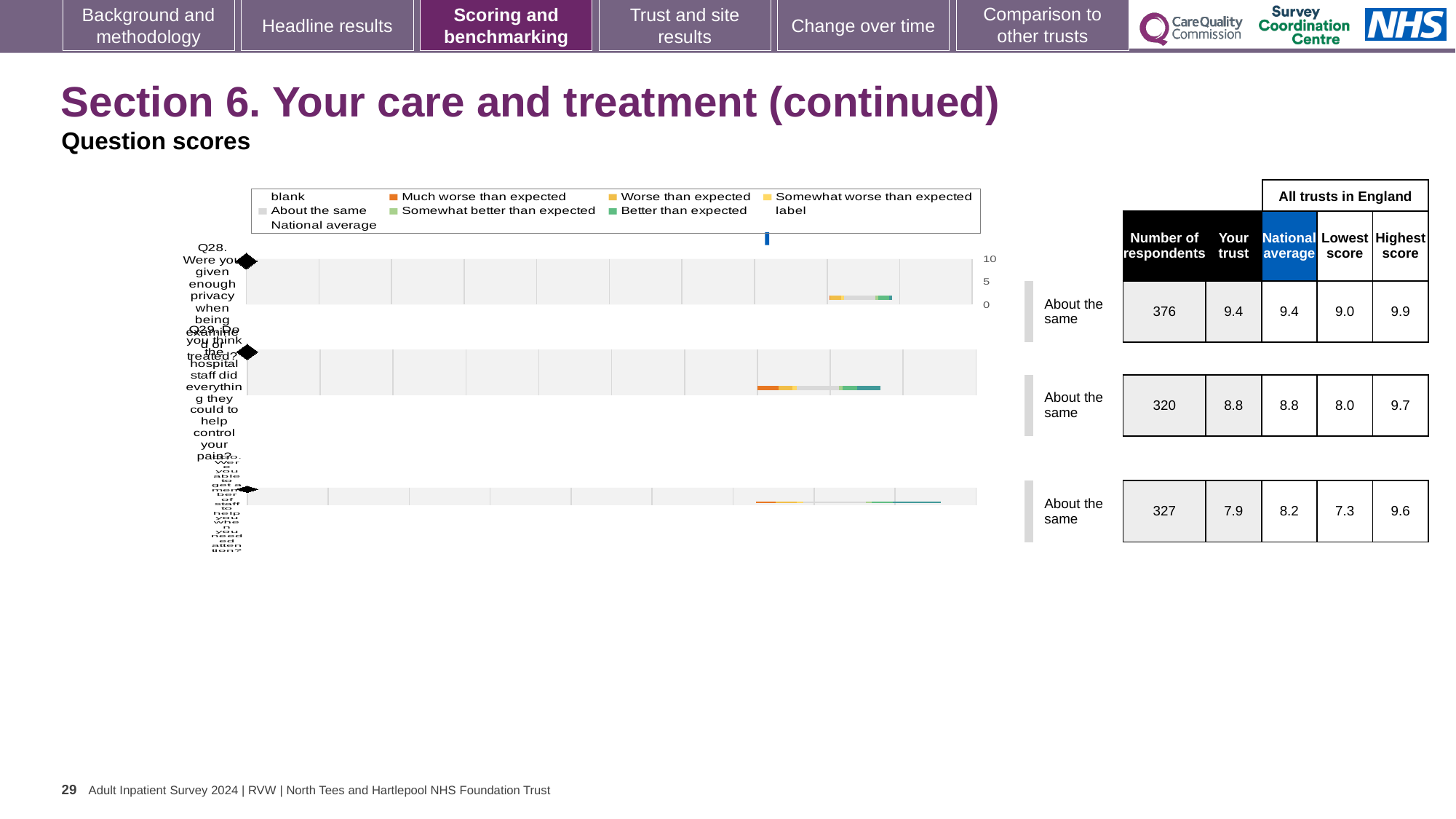
What kind of chart is used to show the question scores on this slide? bar chart Is the 'Your trust' score for Q30 greater or less than 5 on the chart axis? greater What is the difference between the highest score and the lowest score for Q29? 1.7 What benchmark category is shown for Q28? About the same What is the difference between the 'Your trust' scores for Q28 and Q30? 1.5 Which question has the lowest 'Your trust' score? Q30 How many questions are plotted in the chart? 3 What is the 'Your trust' score for Q28 (Were you given enough privacy when being examined or treated?)? 9.4 Which question has the highest 'Your trust' score? Q28 How many respondents answered Q29 (Do you think the hospital staff did everything they could to help control your pain?)? 320 What is the national average score for Q30, the third question on the slide? 8.2 For Q30, which is larger: the 'Your trust' score or the national average? National average